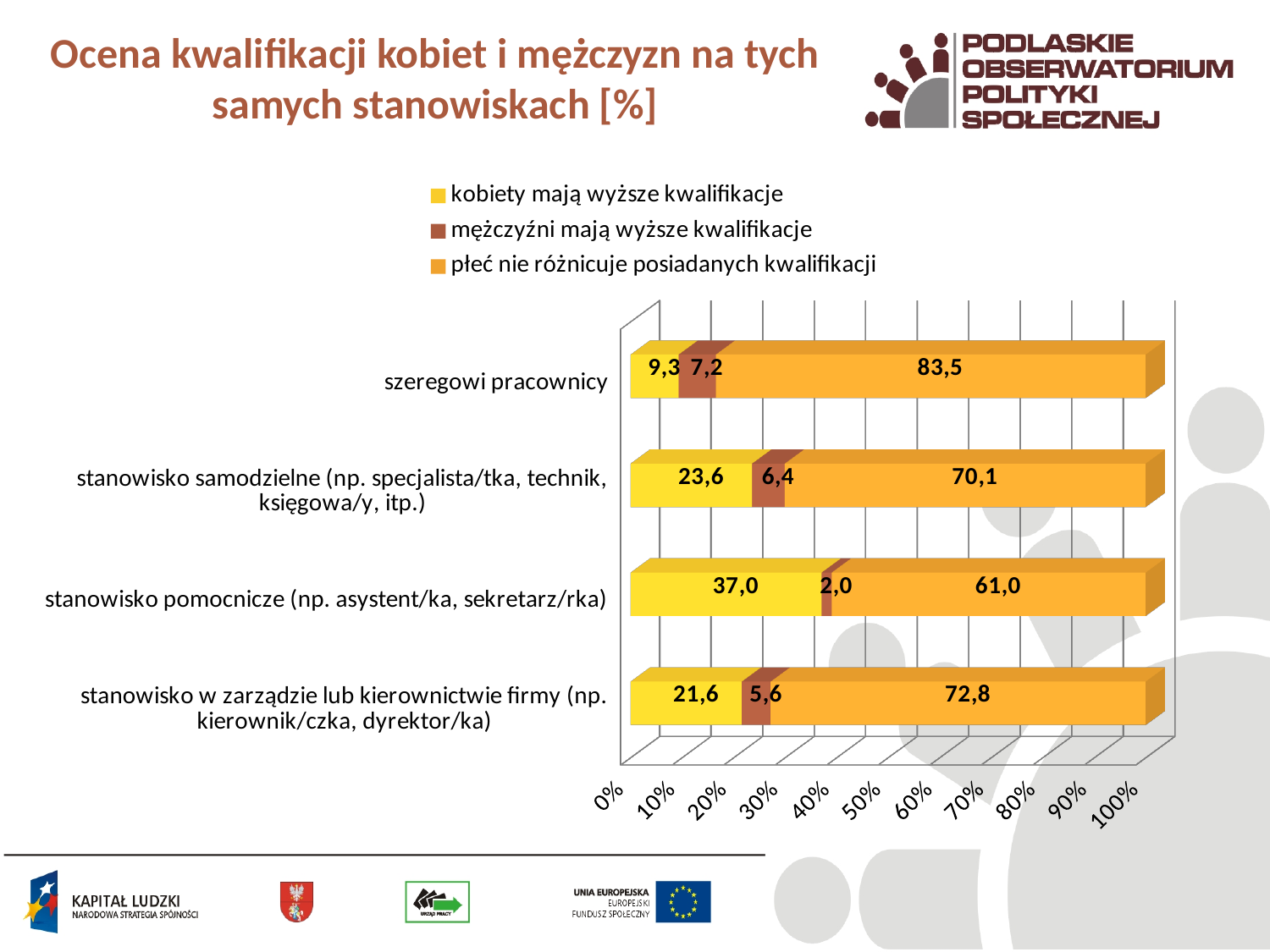
Which category has the highest value for 'kobiety mają wyższe kwalifikacje'? stanowisko pomocnicze (np. asystent/ka, sekretarz/rka) How many series does the legend list? 3 What is the total of the stacked bar for 'stanowisko w zarządzie lub kierownictwie firmy (np. kierownik/czka, dyrektor/ka)'? 100,0 Which category has the lowest value for 'mężczyźni mają wyższe kwalifikacje'? stanowisko pomocnicze (np. asystent/ka, sekretarz/rka) What type of chart is shown on the slide? stacked bar chart What is the value of 'kobiety mają wyższe kwalifikacje' for 'stanowisko w zarządzie lub kierownictwie firmy (np. kierownik/czka, dyrektor/ka)'? 21,6 What is the value of 'płeć nie różnicuje posiadanych kwalifikacji' for 'stanowisko samodzielne (np. specjalista/tka, technik, księgowa/y, itp.)'? 70,1 What is the value of 'kobiety mają wyższe kwalifikacje' for 'szeregowi pracownicy'? 9,3 What is the value of 'mężczyźni mają wyższe kwalifikacje' for 'stanowisko pomocnicze (np. asystent/ka, sekretarz/rka)'? 2,0 Which is larger: the 'mężczyźni mają wyższe kwalifikacje' value for 'szeregowi pracownicy' or for 'stanowisko samodzielne (np. specjalista/tka, technik, księgowa/y, itp.)'? szeregowi pracownicy What is the difference between the 'płeć nie różnicuje posiadanych kwalifikacji' values for 'szeregowi pracownicy' and 'stanowisko pomocnicze (np. asystent/ka, sekretarz/rka)'? 22,5 How many categories (job positions) are shown on the chart? 4